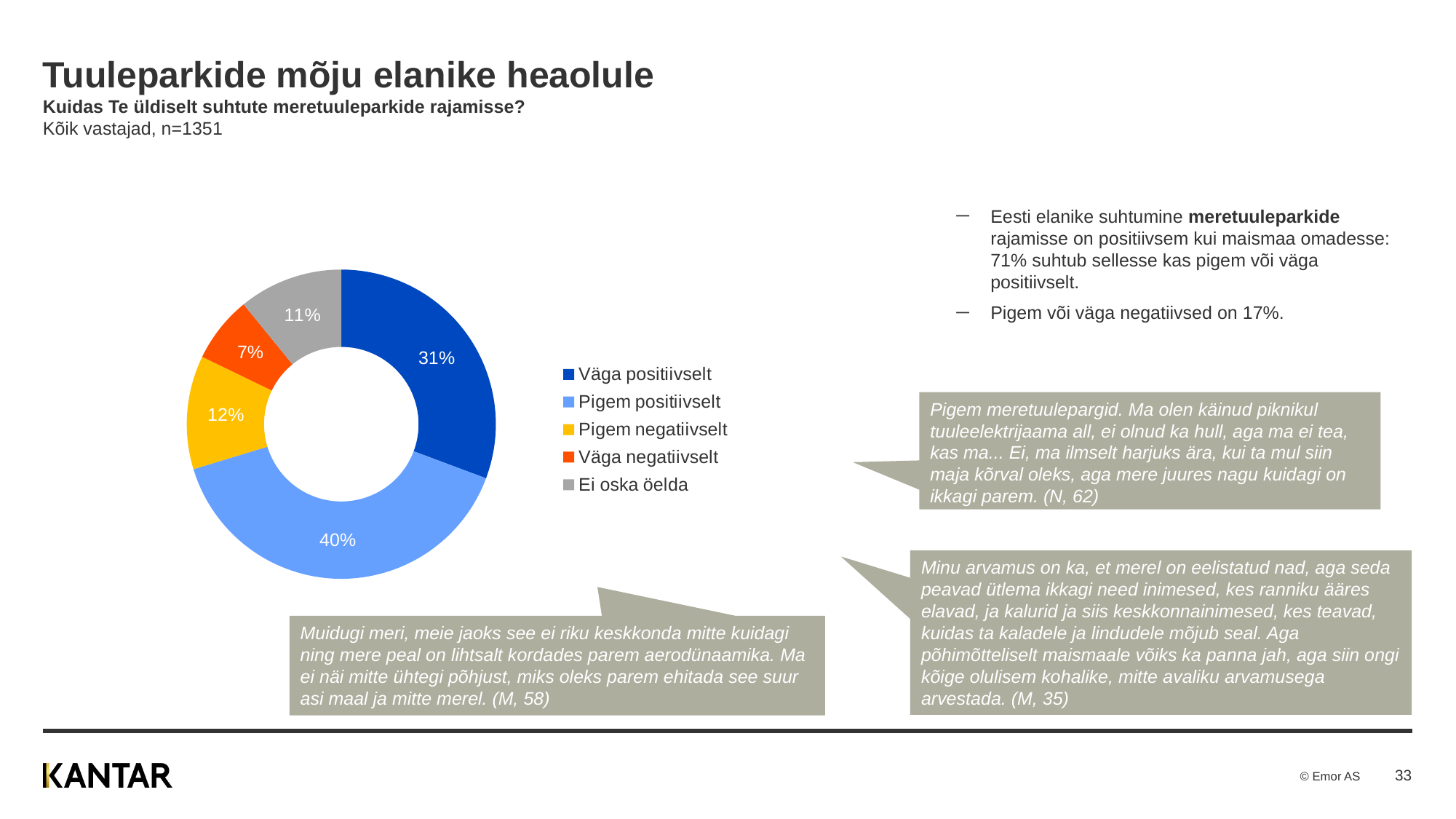
What share of respondents answered "Pigem negatiivselt"? 12% What is the difference in percentage points between "Pigem positiivselt" and "Väga positiivselt"? 9 percentage points Which is larger: the share for "Pigem negatiivselt" or for "Ei oska öelda"? Pigem negatiivselt What share of respondents answered "Pigem positiivselt"? 40% What share of respondents answered "Väga negatiivselt"? 7% What share of respondents answered "Ei oska öelda"? 11% Which response category has the smallest share? Väga negatiivselt What kind of chart is shown on the slide? Donut (pie) chart Which response category has the largest share? Pigem positiivselt Which colour represents "Väga negatiivselt" in the chart? Orange-red How many response categories does the chart show? 5 What share of respondents answered "Väga positiivselt"? 31%